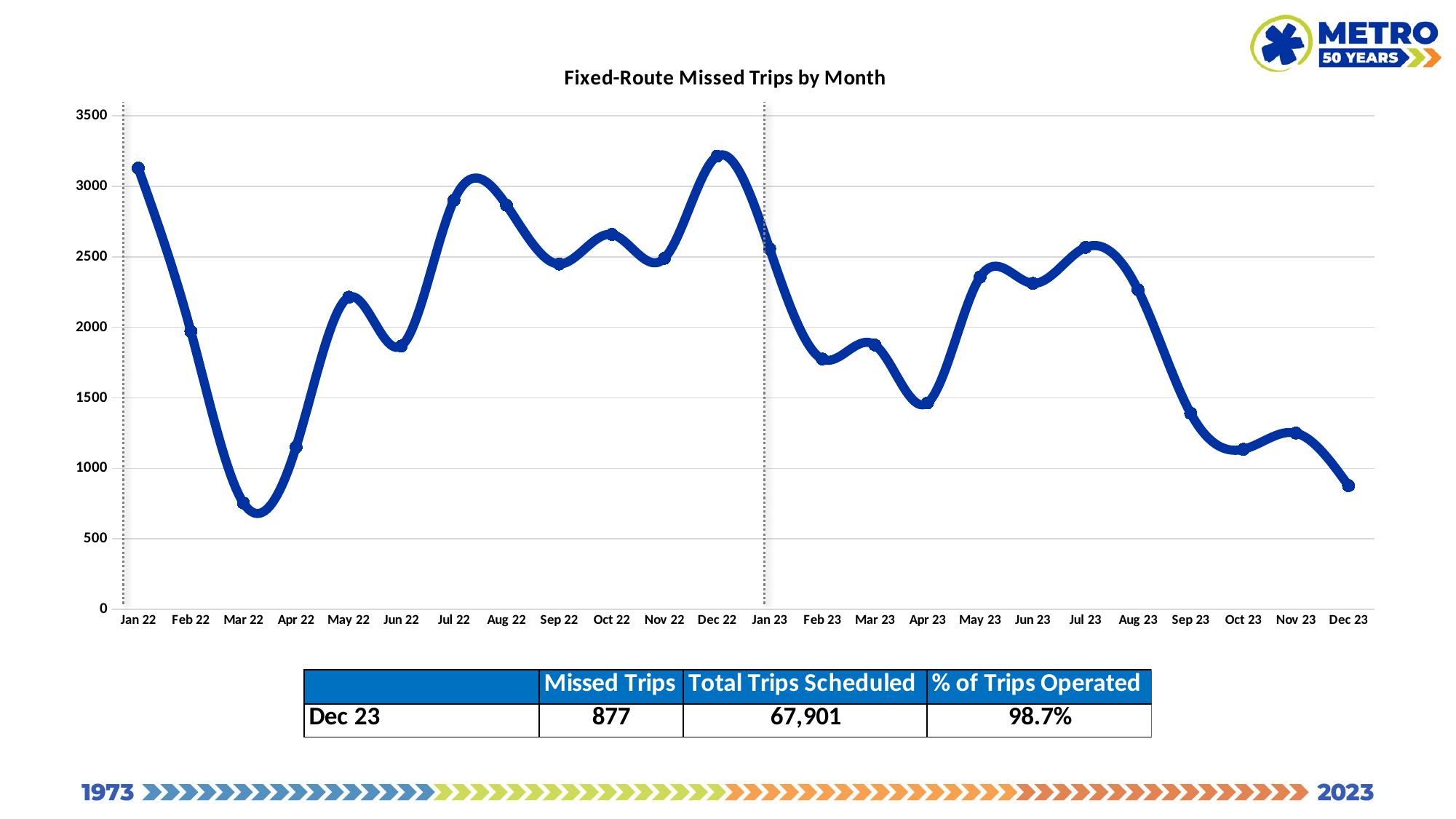
Which month has the lowest number of missed trips? Mar 22 What is the title of the chart? Fixed-Route Missed Trips by Month Is the value for Jan 22 greater or less than 3000? greater Do missed trips rise or fall overall from Jan 22 to Dec 23? fall Is the value for Jul 22 greater or less than 2500? greater Is the value for Mar 22 greater or less than 1000? less How many missed trips were there in Dec 23? 877 How many months are plotted on the chart? 24 What kind of chart is shown on the slide? line chart Which month has more missed trips, Jan 22 or Feb 22? Jan 22 Which month has the highest number of missed trips? Dec 22